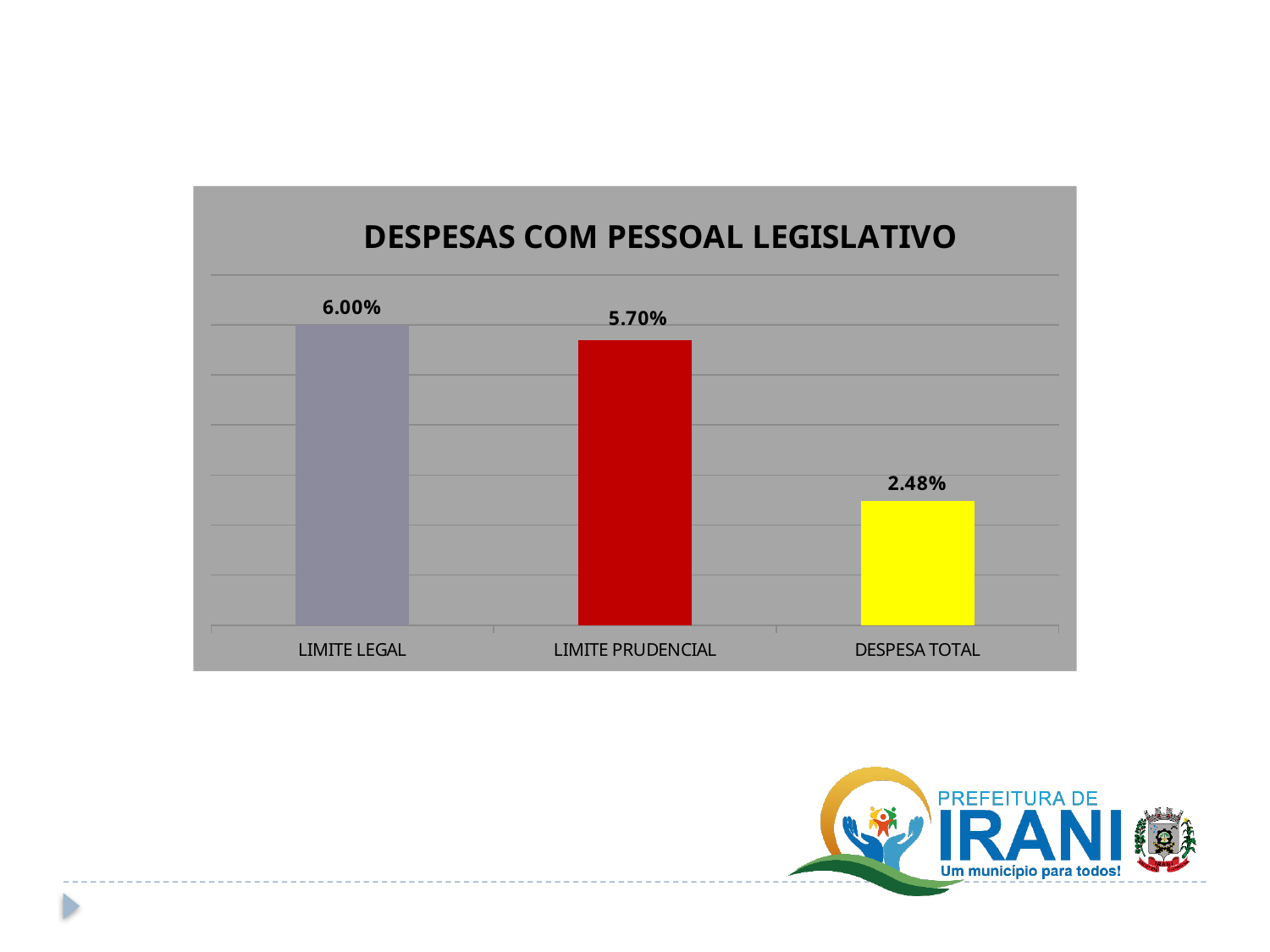
What is the difference between LIMITE LEGAL and LIMITE PRUDENCIAL? 0.30% What is the title of the chart? DESPESAS COM PESSOAL LEGISLATIVO What is the value for LIMITE LEGAL? 6.00% What kind of chart is shown on the slide? Bar chart What is the difference between LIMITE PRUDENCIAL and DESPESA TOTAL? 3.22% Which category has the highest value? LIMITE LEGAL What is the value for DESPESA TOTAL? 2.48% Which category has the lowest value? DESPESA TOTAL How many categories are shown in the chart? 3 What colour is the bar for DESPESA TOTAL? Yellow Which is larger, LIMITE PRUDENCIAL or DESPESA TOTAL? LIMITE PRUDENCIAL What is the value for LIMITE PRUDENCIAL? 5.70%